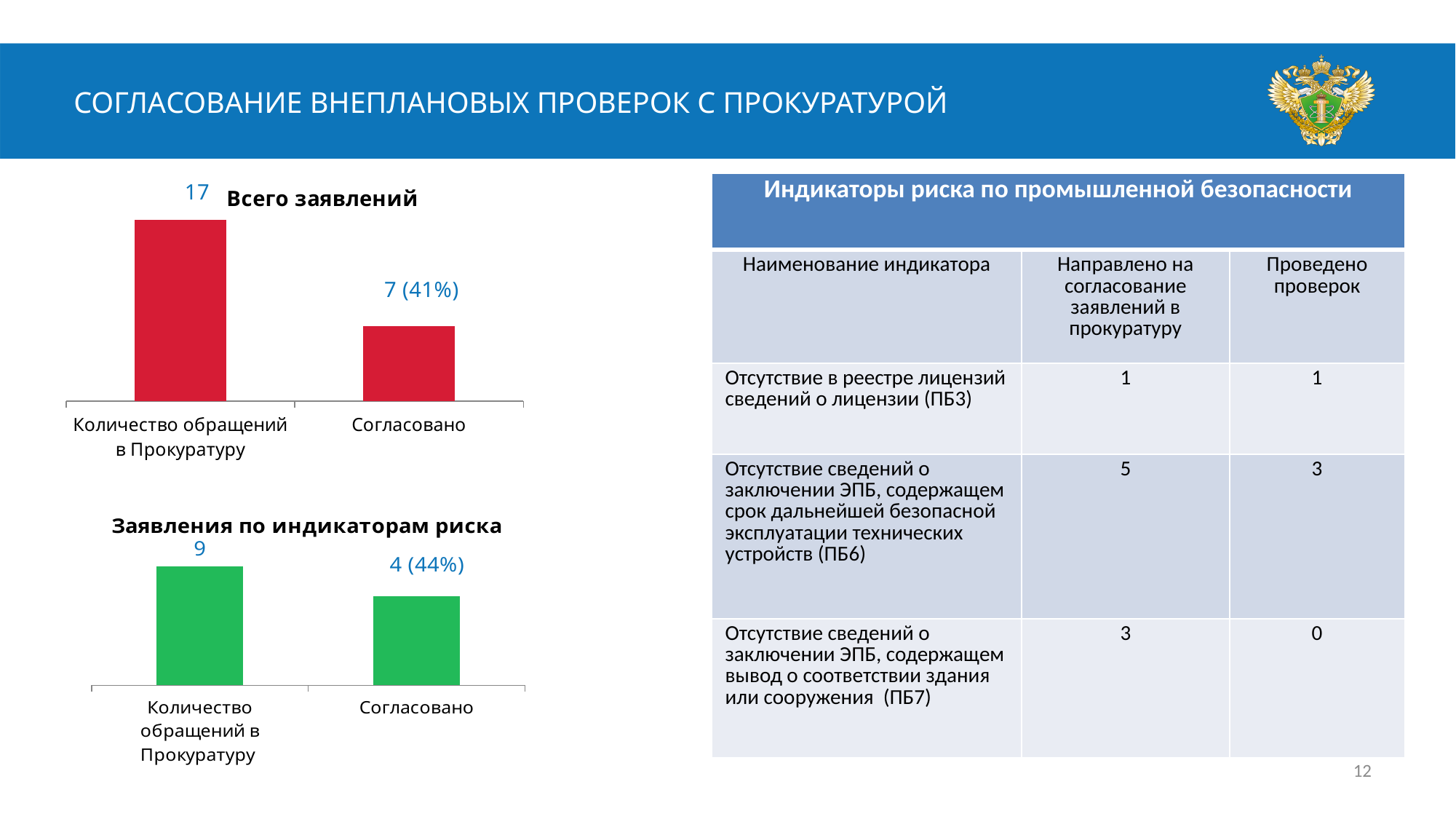
How many bars are shown in the chart titled "Заявления по индикаторам риска"? 2 In the chart titled "Заявления по индикаторам риска", what is the data label shown for "Согласовано"? 4 (44%) In the chart titled "Заявления по индикаторам риска", what is the difference between "Количество обращений в Прокуратуру" and "Согласовано"? 5 What type of chart is "Всего заявлений"? bar chart In the chart titled "Всего заявлений", which category has the highest value? Количество обращений в Прокуратуру Is the value for "Количество обращений в Прокуратуру" in the chart "Всего заявлений" larger or smaller than the value for the same category in the chart "Заявления по индикаторам риска"? larger In the chart titled "Заявления по индикаторам риска", which category has the lowest value? Согласовано In the chart titled "Всего заявлений", what is the difference between the number of applications sent to the prosecutor's office and the number approved? 10 In the chart titled "Всего заявлений", what is the value for "Количество обращений в Прокуратуру"? 17 What colour are the bars in the chart titled "Заявления по индикаторам риска"? green In the chart titled "Заявления по индикаторам риска", what is the value for "Количество обращений в Прокуратуру"? 9 In the chart titled "Всего заявлений", what is the data label shown for "Согласовано"? 7 (41%)